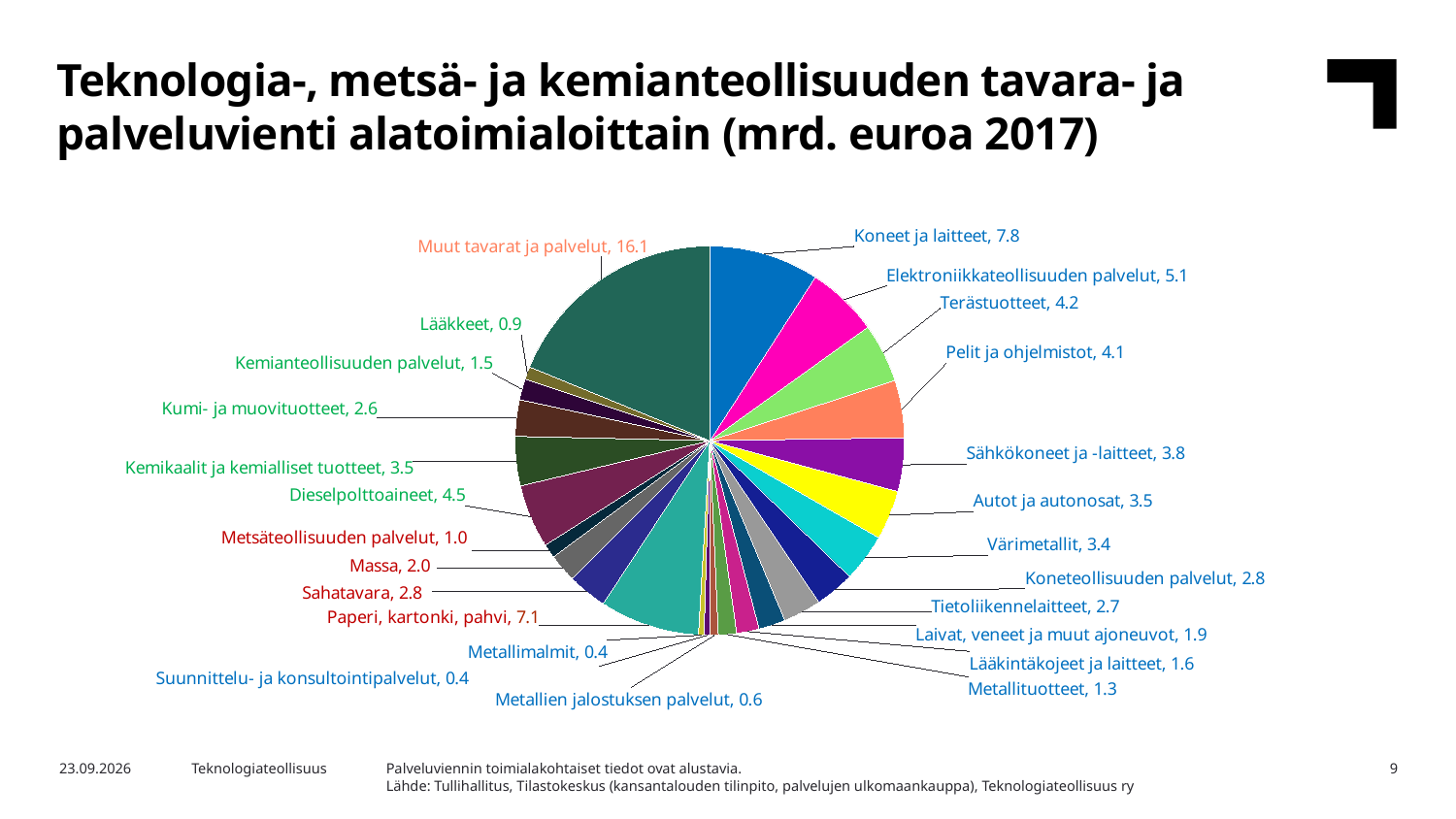
Which is larger, Sahatavara or Massa? Sahatavara Which is larger, Terästuotteet or Pelit ja ohjelmistot? Terästuotteet What unit and year does the slide title give for the values? mrd. euroa 2017 What is the value for Lääkkeet? 0.9 What is the difference between Koneet ja laitteet and Paperi, kartonki, pahvi? 0.7 What is the value for Dieselpolttoaineet? 4.5 What is the value for Koneet ja laitteet? 7.8 Which slice has the largest value? Muut tavarat ja palvelut What is the value for Paperi, kartonki, pahvi? 7.1 How many slices does the pie chart have? 25 What type of chart is shown on the slide? pie chart What is the difference between Muut tavarat ja palvelut and Koneet ja laitteet? 8.3